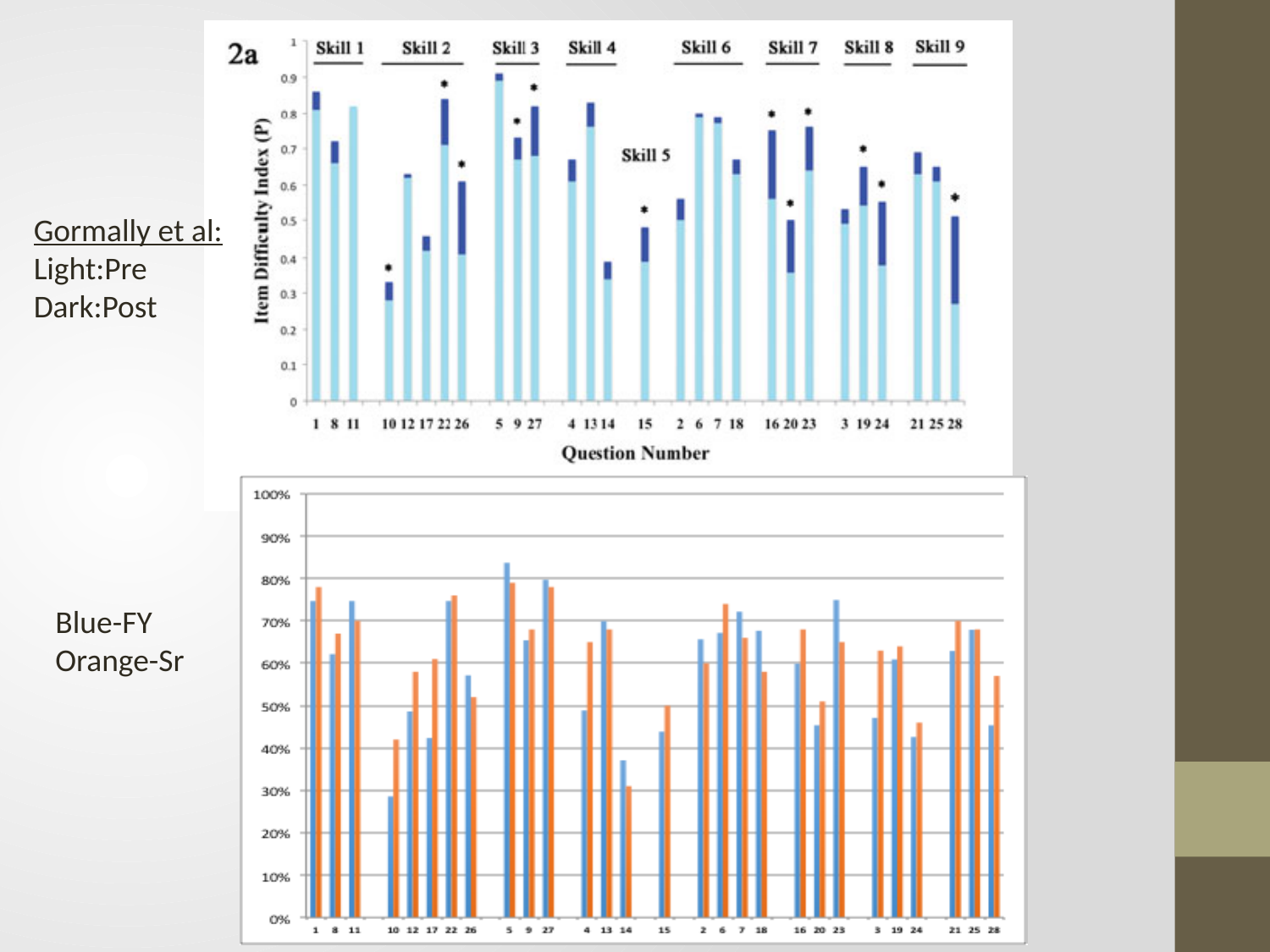
How many question numbers are shown along the x axis of the bottom chart (Blue-FY / Orange-Sr)? 28 How many series does the bottom chart (Blue-FY / Orange-Sr) show? 2 What kind of chart is the top chart labelled 2a (Gormally et al.)? bar chart In the bottom chart (Blue-FY / Orange-Sr), which question number has the highest blue (FY) bar? 5 In the bottom chart (Blue-FY / Orange-Sr), is the orange (Sr) value for question 14 greater or less than 40%? less In the top chart (2a), is the light (Pre) value for question 10 greater or less than 0.4? less In the top chart (2a), what is the x-axis title? Question Number In the bottom chart (Blue-FY / Orange-Sr), is the blue (FY) value for question 5 greater or less than 80%? greater In the top chart (2a), what is the y-axis title? Item Difficulty Index (P) What kind of chart is the bottom chart (Blue-FY / Orange-Sr)? bar chart In the bottom chart (Blue-FY / Orange-Sr), for question 10, which is larger: the blue (FY) bar or the orange (Sr) bar? orange (Sr)